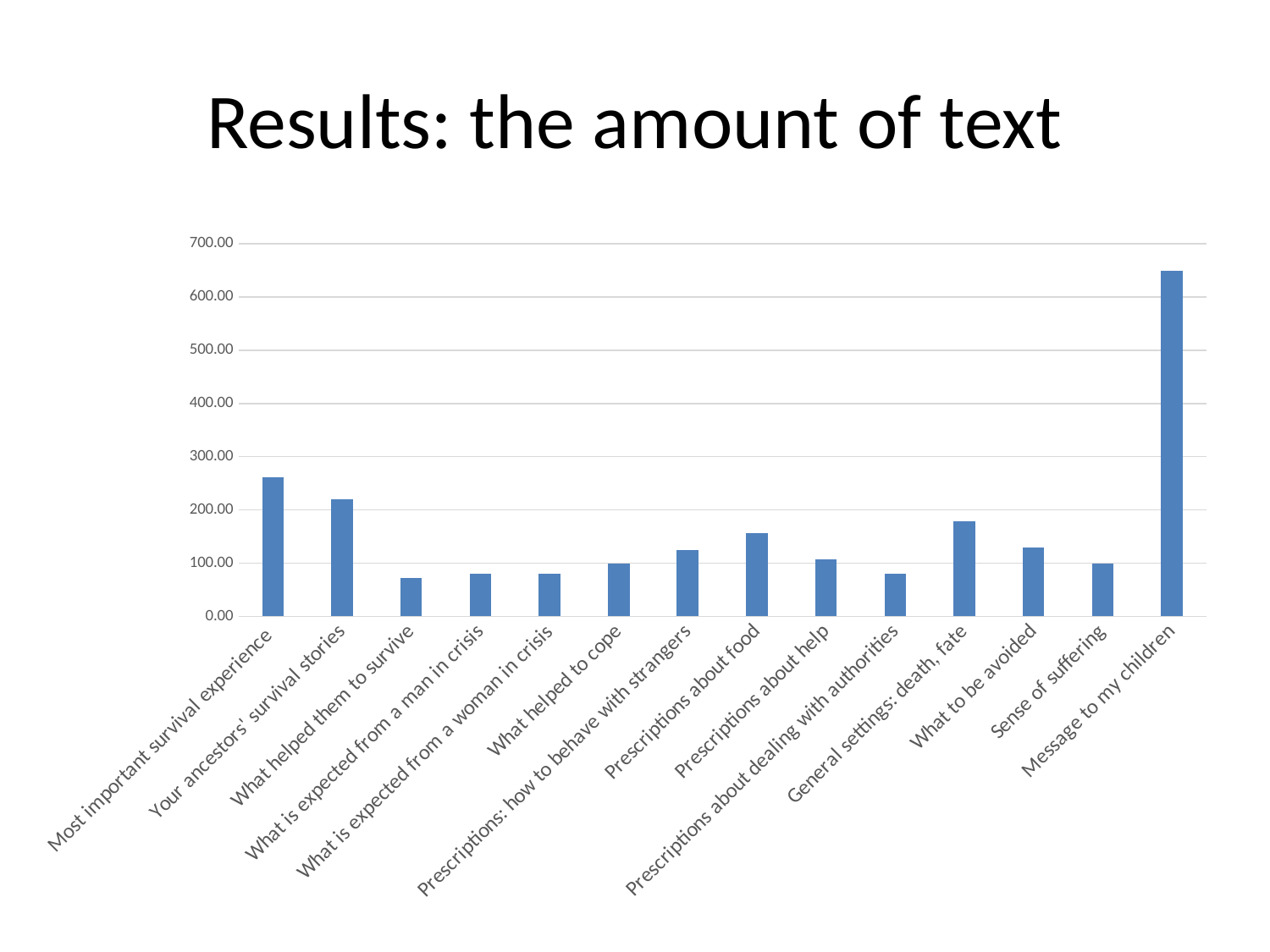
Which is larger, the value for General settings: death, fate or the value for What to be avoided? General settings: death, fate Is the value for Most important survival experience greater or less than 200? greater Which is larger, the value for Prescriptions about food or the value for Prescriptions about help? Prescriptions about food Which category has the highest value in the chart? Message to my children Is the value for General settings: death, fate greater or less than 100? greater Which is larger, the value for Most important survival experience or the value for Your ancestors' survival stories? Most important survival experience What kind of chart is shown on the slide? bar chart Is the value for Message to my children greater or less than 600? greater How many categories are plotted on the x axis of the chart? 14 What is the title of the slide containing the chart? Results: the amount of text